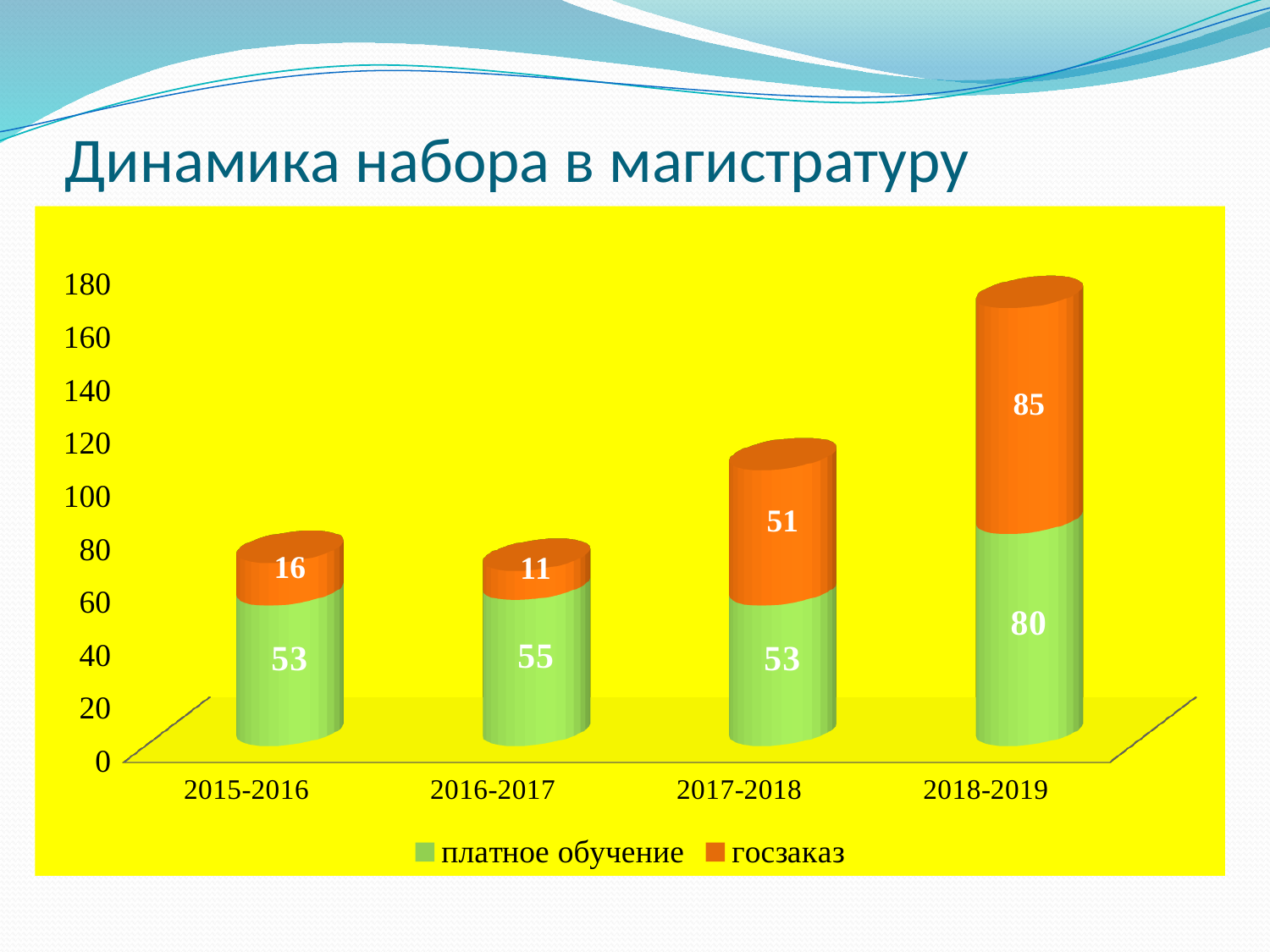
What is the value for госзаказ in 2017-2018? 51 Which year has the lowest value for госзаказ? 2016-2017 Which year has the highest value for госзаказ? 2018-2019 Which is larger: платное обучение in 2018-2019 or госзаказ in 2018-2019? госзаказ in 2018-2019 What is the difference between госзаказ in 2018-2019 and госзаказ in 2017-2018? 34 How many series does the legend list? 2 What is the value for платное обучение in 2018-2019? 80 What is the total of the stacked bar for 2015-2016? 69 How many year categories are shown on the x axis? 4 What is the value for госзаказ in 2016-2017? 11 What kind of chart is shown on the slide? Stacked bar chart What is the total of the stacked bar for 2018-2019? 165